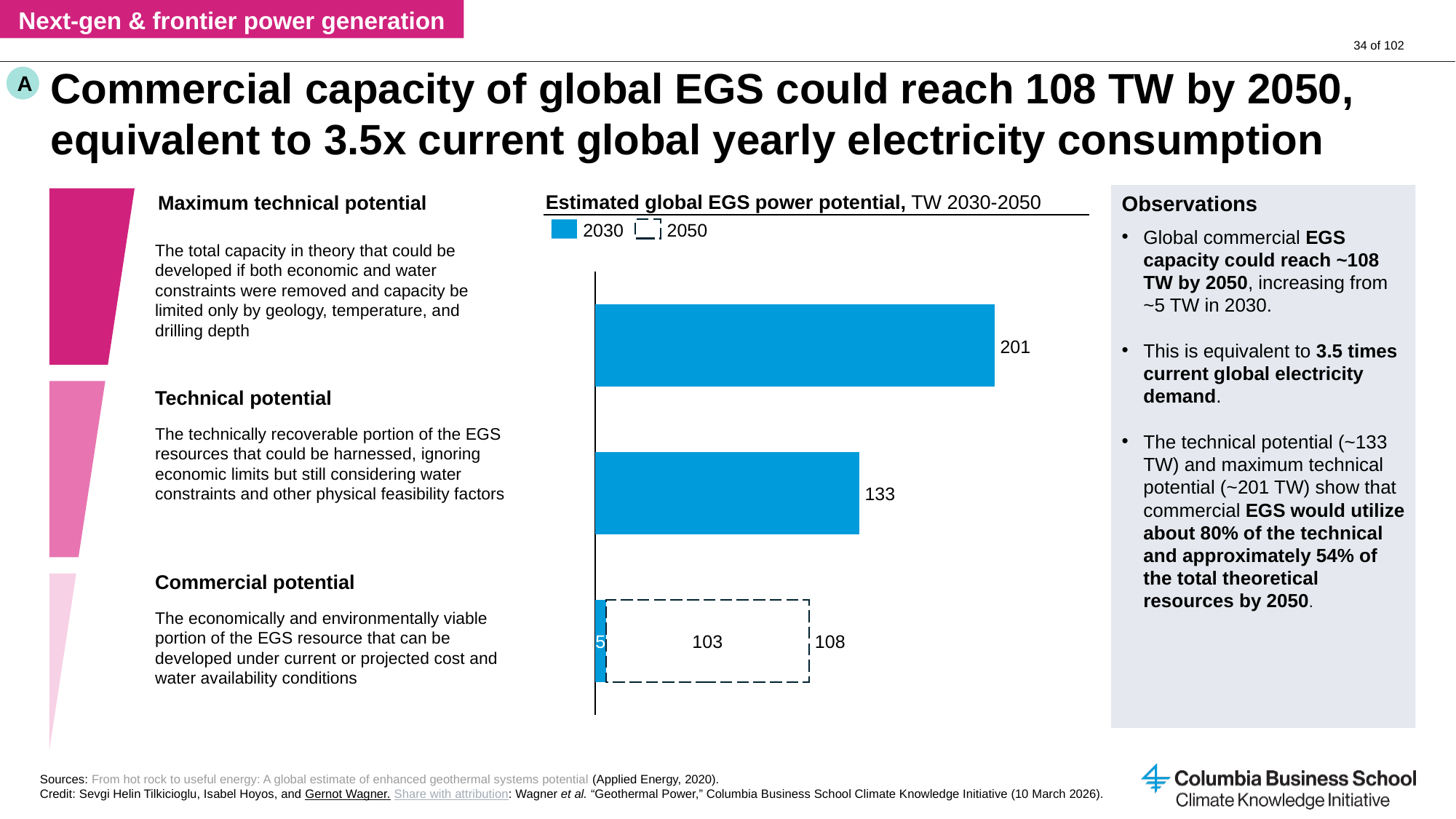
Which is larger, the technical potential or the commercial potential in 2050? Technical potential What is the commercial potential for 2030 shown in the chart, in TW? 5 What is the maximum technical potential value shown in the chart, in TW? 201 What is the difference between the maximum technical potential (201) and the technical potential (133)? 68 What is the commercial potential for 2050 shown in the chart, in TW? 108 Which category has the lowest value in the chart? Commercial potential Which category has the highest value in the chart? Maximum technical potential What type of chart is used to show the estimated global EGS power potential? bar chart What is the title of the chart? Estimated global EGS power potential, TW 2030-2050 How many series does the chart legend list? 2 By how much does commercial potential increase from 2030 to 2050 according to the label on the dashed bar? 103 What is the technical potential value shown in the chart, in TW? 133